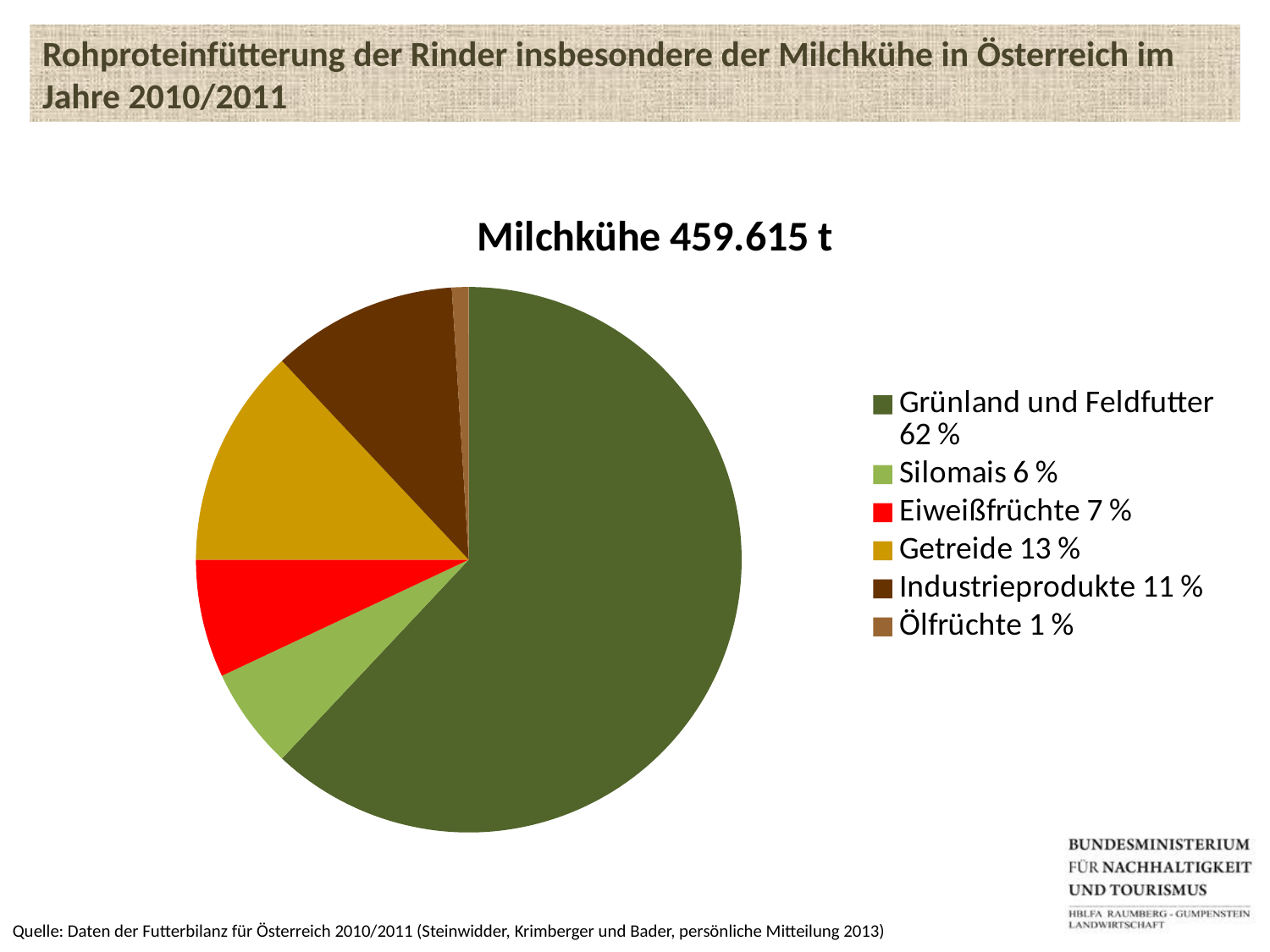
What is the title of the pie chart? Milchkühe 459.615 t What share of the pie does Industrieprodukte have? 11 % What share of the pie does Getreide have? 13 % What share of the pie does Silomais have? 6 % Which has the larger share, Getreide or Industrieprodukte? Getreide What is the difference in percentage points between Grünland und Feldfutter and Getreide? 49 Which category has the smallest share of the pie? Ölfrüchte How many slices does the pie chart have? 6 Which category has the largest share of the pie? Grünland und Feldfutter What colour is the Eiweißfrüchte slice? red What kind of chart is shown on the slide? pie chart